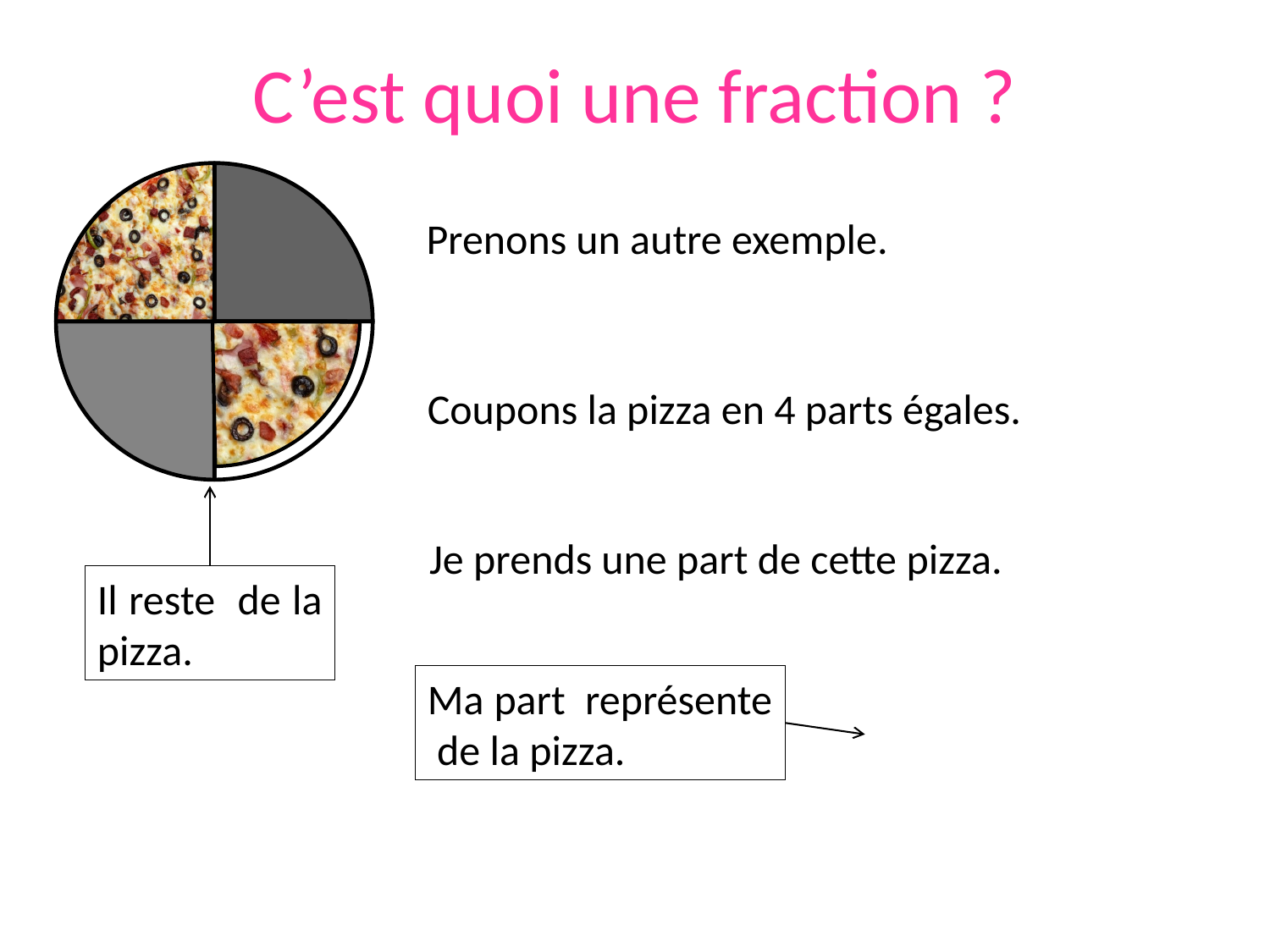
How many equal parts is the pizza on the slide divided into? 4 How many of the four pizza slices in the diagram are shown in grey? 2 What is the title of the slide containing the pizza diagram? C'est quoi une fraction ? How many of the four pizza slices in the diagram still show the pizza image? 2 What kind of chart or diagram is used to show the pizza on the slide? pie chart According to the slide, what fraction of the pizza does one part represent? 1/4